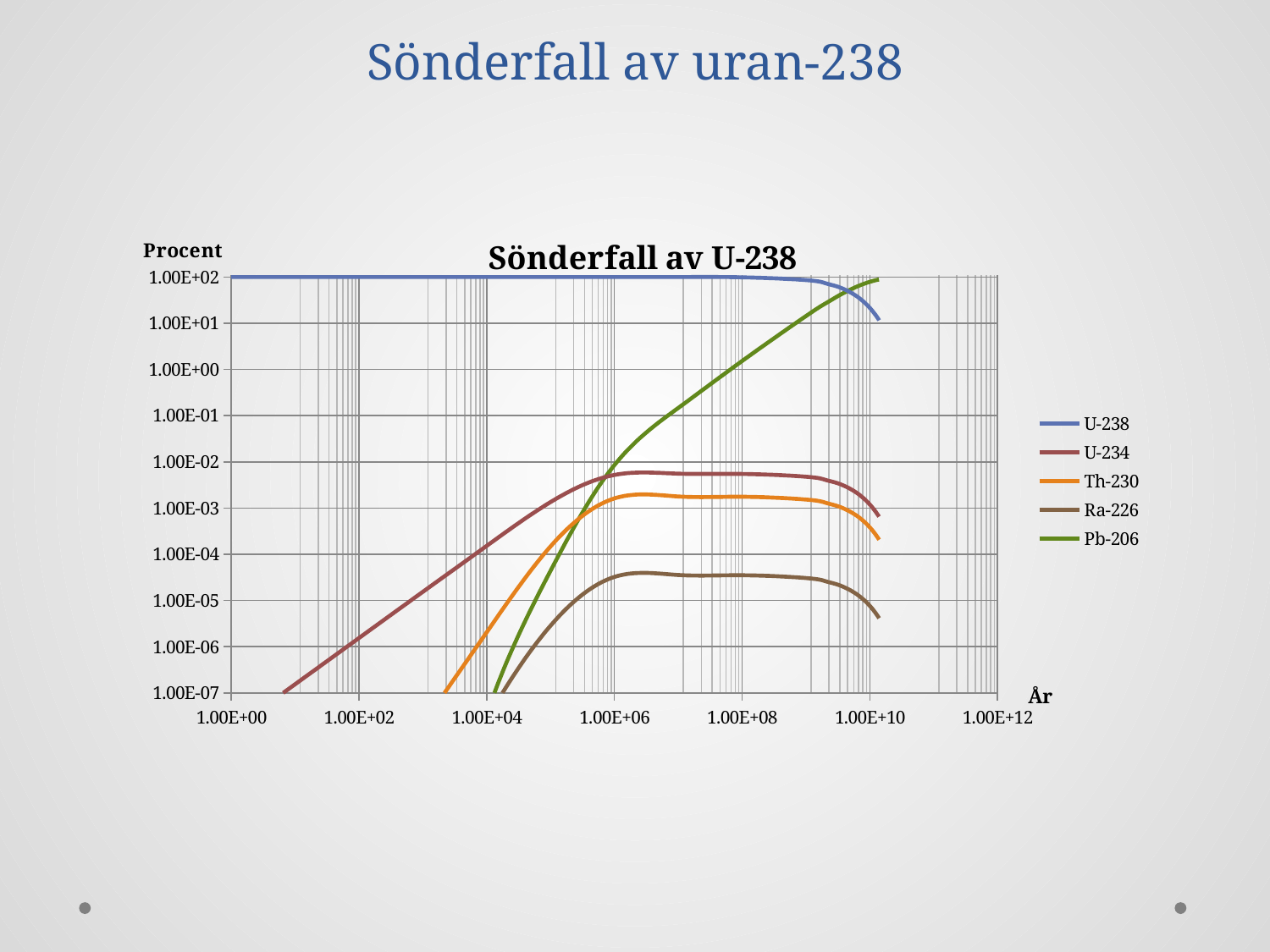
Which series has the highest value at 1.00E+02 years? U-238 Is the value for Th-230 at 1.00E+08 years greater or less than 1.00E-02? less Which series has the lowest value at 1.00E+08 years? Ra-226 How many series does the chart legend list? 5 At 1.00E+08 years, which is larger, the value for Pb-206 or the value for Th-230? Pb-206 What is the title of the chart? Sönderfall av U-238 Is the value for Pb-206 at 1.00E+08 years greater or less than 1.00E-01? greater Is the value for U-238 at 1.00E+04 years greater or less than 1.00E+01? greater At 1.00E+08 years, which is larger, the value for U-234 or the value for Ra-226? U-234 Does the Pb-206 series rise or fall as the number of years increases? Rises What is the label of the vertical axis of the chart? Procent What kind of chart is shown on the slide? Line chart